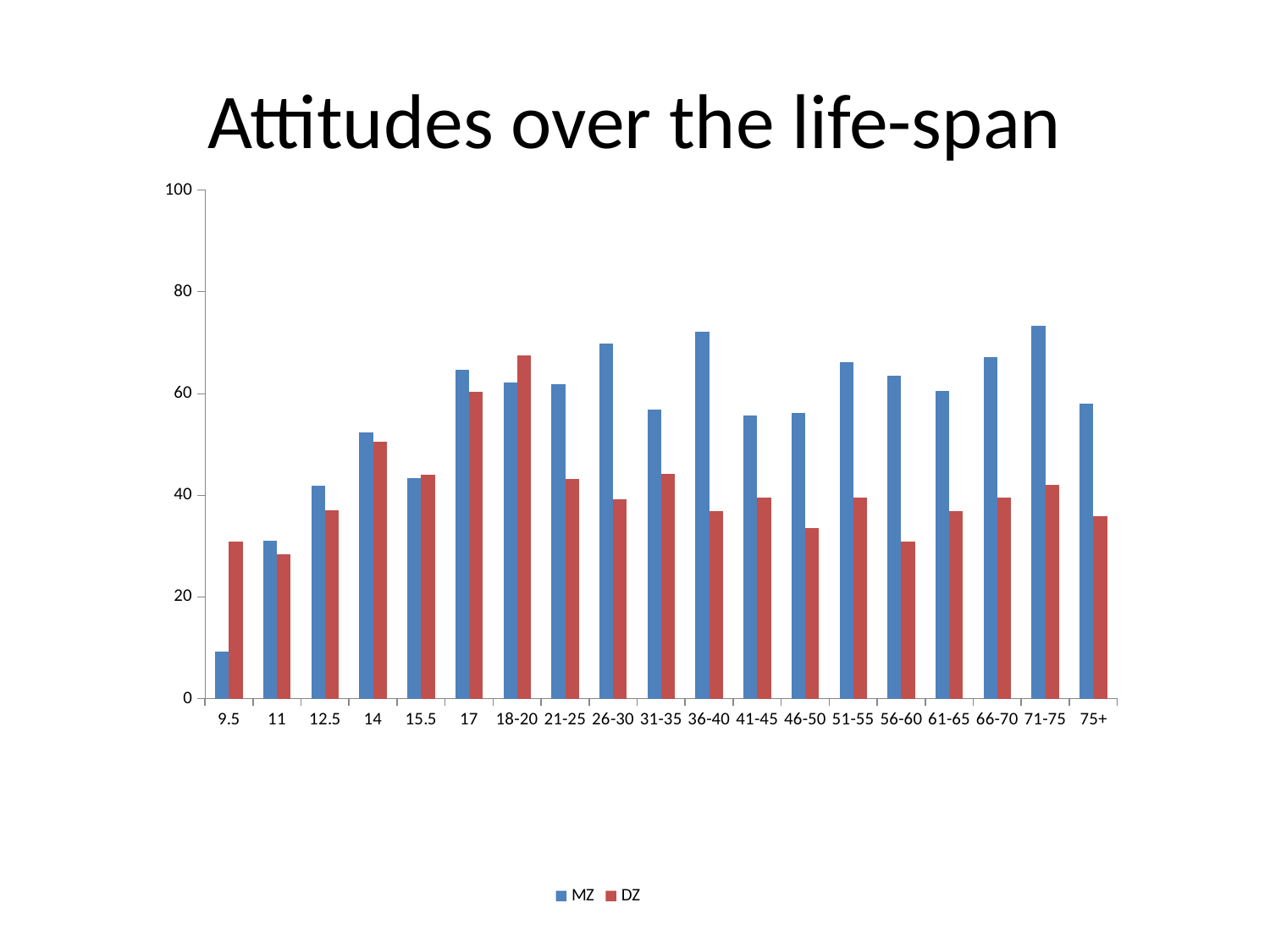
Is the MZ value for 9.5 greater or less than 20? less How many series does the legend list? 2 Which age category has the highest DZ value? 18-20 Is the DZ value for 18-20 greater or less than 60? greater For the 36-40 category, which series has the larger value, MZ or DZ? MZ Is the MZ value for 36-40 greater or less than 60? greater Which age category has the lowest MZ value? 9.5 For the 9.5 category, which series has the larger value, MZ or DZ? DZ How many age categories are shown on the x axis? 19 What is the title of the chart? Attitudes over the life-span What kind of chart is shown on the slide? bar chart